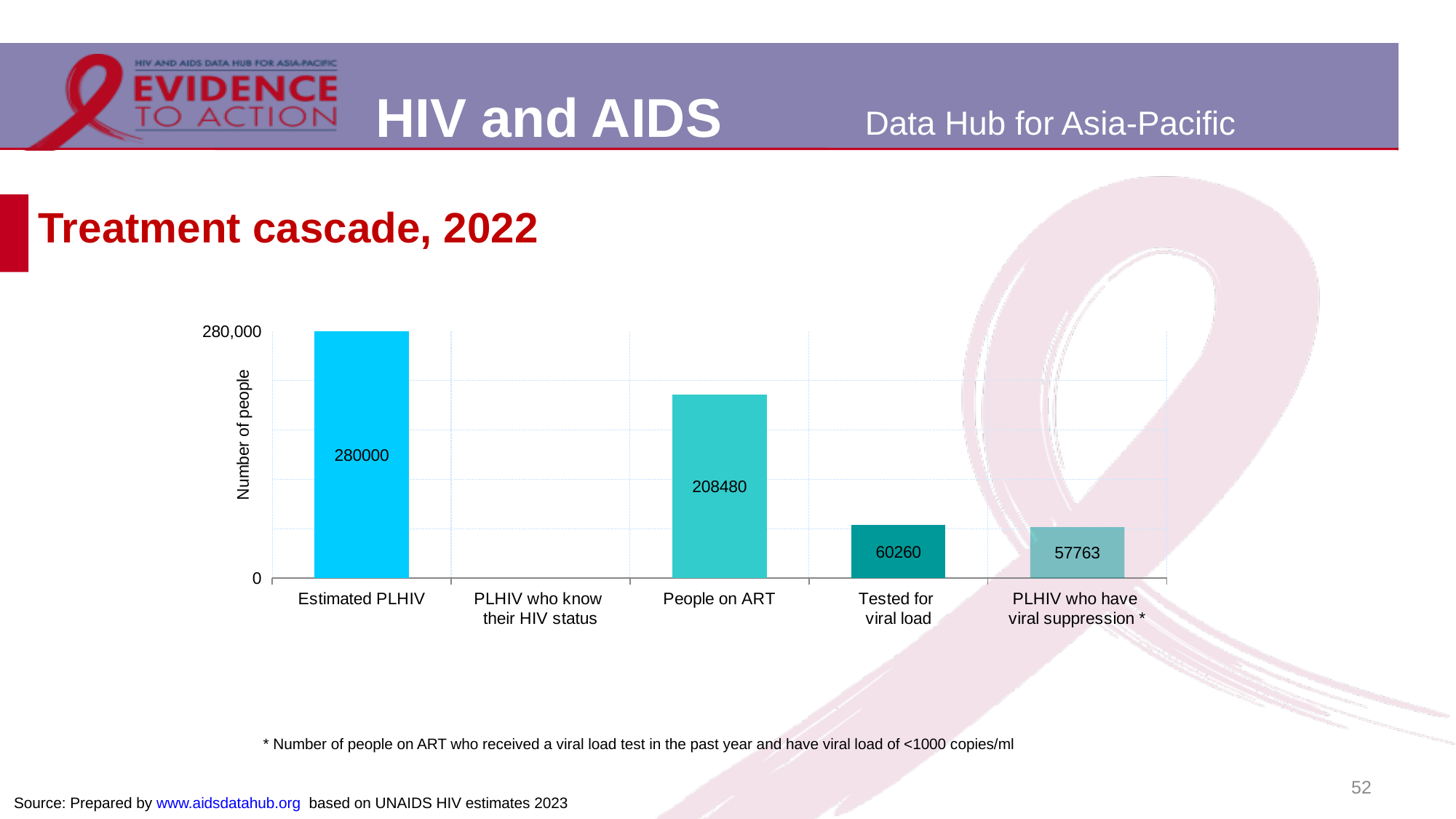
What is the value for PLHIV who have viral suppression? 57763 What is the value for Tested for viral load? 60260 How many categories are listed on the x axis? 5 What is the difference between Tested for viral load and PLHIV who have viral suppression? 2497 What is the value for Estimated PLHIV? 280000 Which is larger, the value for People on ART or the value for Tested for viral load? People on ART What is the difference between Estimated PLHIV and People on ART? 71520 Among the bars with data labels, which category has the lowest value? PLHIV who have viral suppression What is the label of the y axis? Number of people Which category has the highest value? Estimated PLHIV What type of chart is shown on the slide? Bar chart What is the value for People on ART? 208480